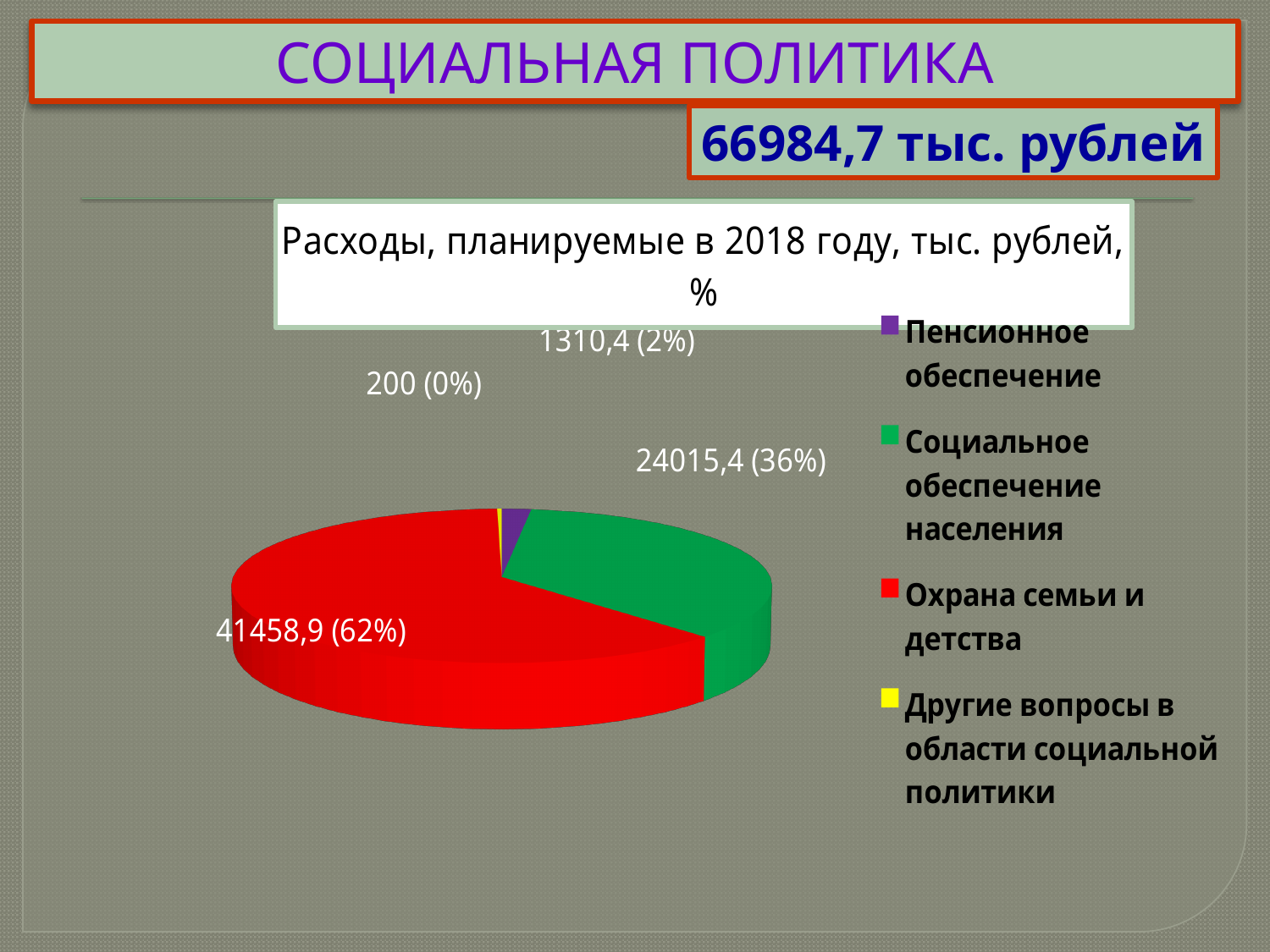
What share of the pie does Социальное обеспечение населения take? 36% Which category has the largest slice of the pie? Охрана семьи и детства What is the value shown for Охрана семьи и детства? 41458,9 What is the value shown for Другие вопросы в области социальной политики? 200 What kind of chart is shown on the slide? pie chart What share of the pie does Охрана семьи и детства take? 62% What is the value shown for Социальное обеспечение населения? 24015,4 Which category has the smallest slice of the pie? Другие вопросы в области социальной политики What is the title of the chart? Расходы, планируемые в 2018 году, тыс. рублей, % How many categories does the legend of the pie chart list? 4 Which colour represents Социальное обеспечение населения in the pie chart? green What is the value shown for Пенсионное обеспечение? 1310,4